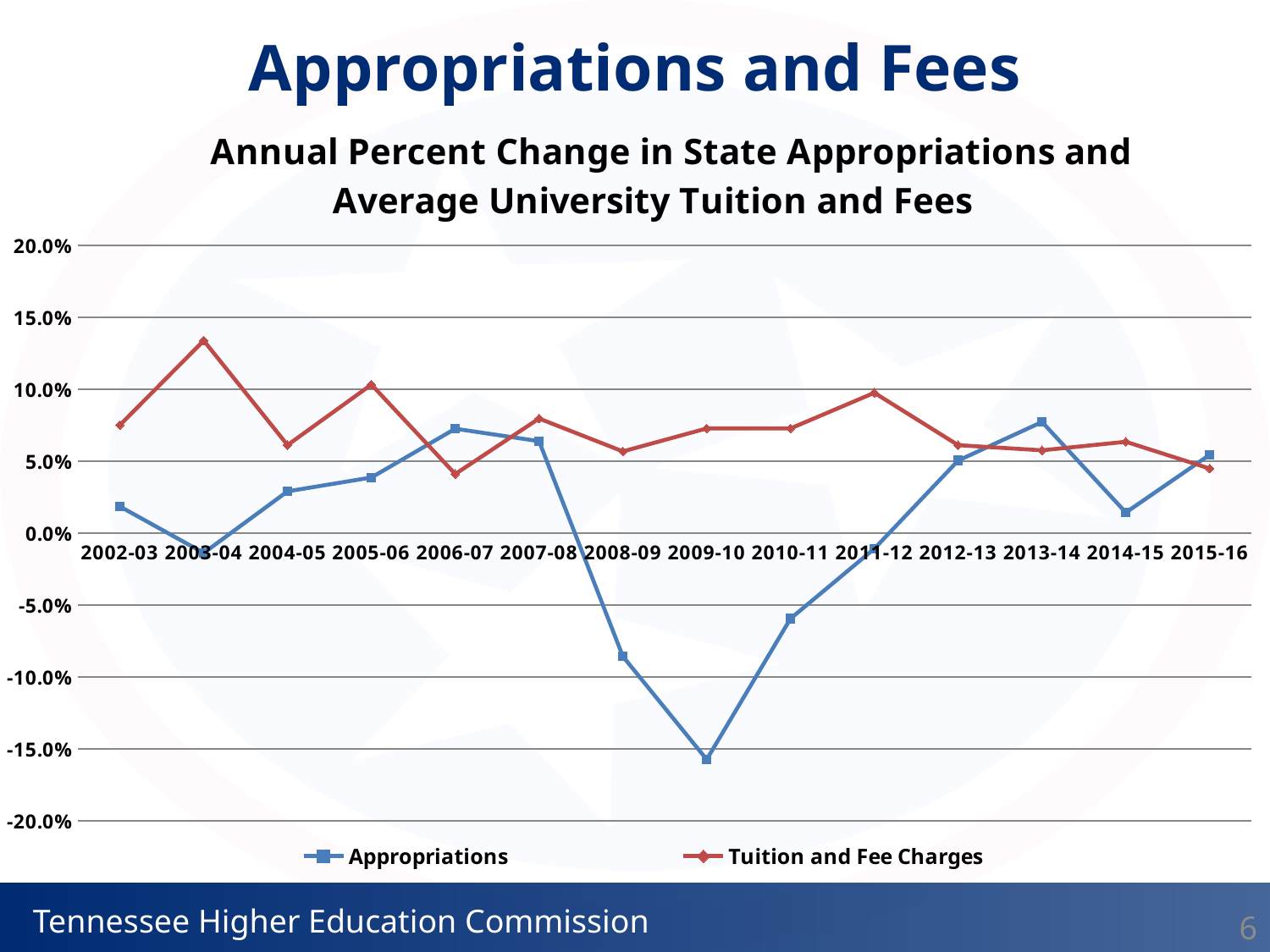
In which year is the Tuition and Fee Charges value highest? 2003-04 In 2008-09, which series has the larger value, Appropriations or Tuition and Fee Charges? Tuition and Fee Charges Is the Appropriations value for 2013-14 greater or less than 5.0%? greater How many academic years are plotted along the x axis? 14 In which year is the Appropriations value lowest? 2009-10 What kind of chart is shown on the slide? line chart Does the Appropriations line rise or fall from 2009-10 to 2013-14? rise In 2006-07, which series has the larger value, Appropriations or Tuition and Fee Charges? Appropriations Is the Appropriations value for 2009-10 greater or less than -10.0%? less How many series does the legend list? 2 What colour is the Tuition and Fee Charges line? red Is the Tuition and Fee Charges value for 2003-04 greater or less than 10.0%? greater